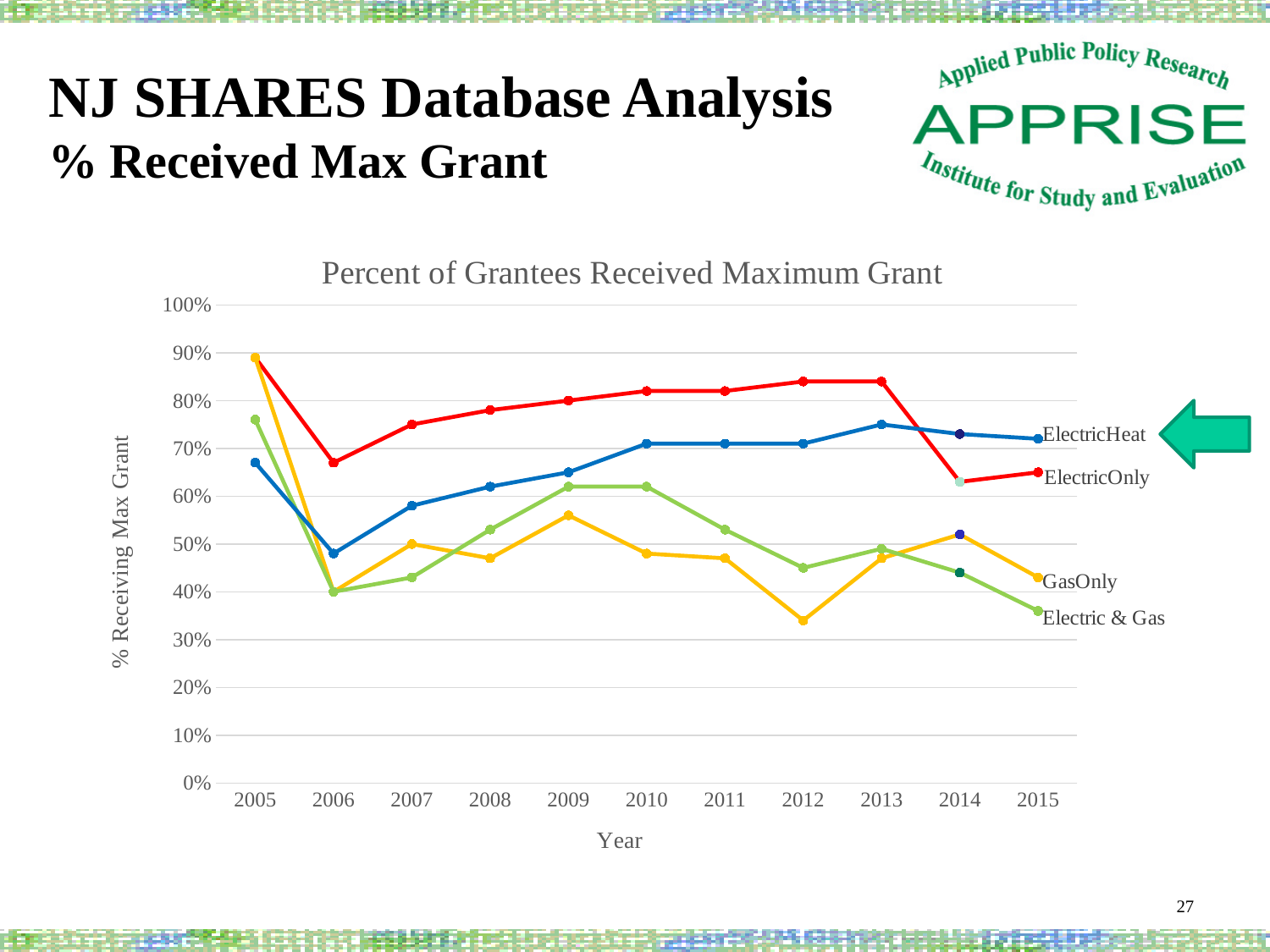
In which year does the ElectricOnly series reach its highest value? 2005 What kind of chart is shown on the slide? line chart How many series are labelled on the chart? 4 Is the value for ElectricHeat in 2005 greater or less than 60%? greater Is the value for GasOnly in 2012 greater or less than 40%? less How many years are plotted along the x axis of the chart? 11 Which series has the lowest value in 2012? GasOnly In 2013, which is larger: ElectricOnly or Electric & Gas? ElectricOnly Is the value for Electric & Gas in 2015 greater or less than 40%? less What is the title of the chart? Percent of Grantees Received Maximum Grant Which series has the highest value in 2010? ElectricOnly